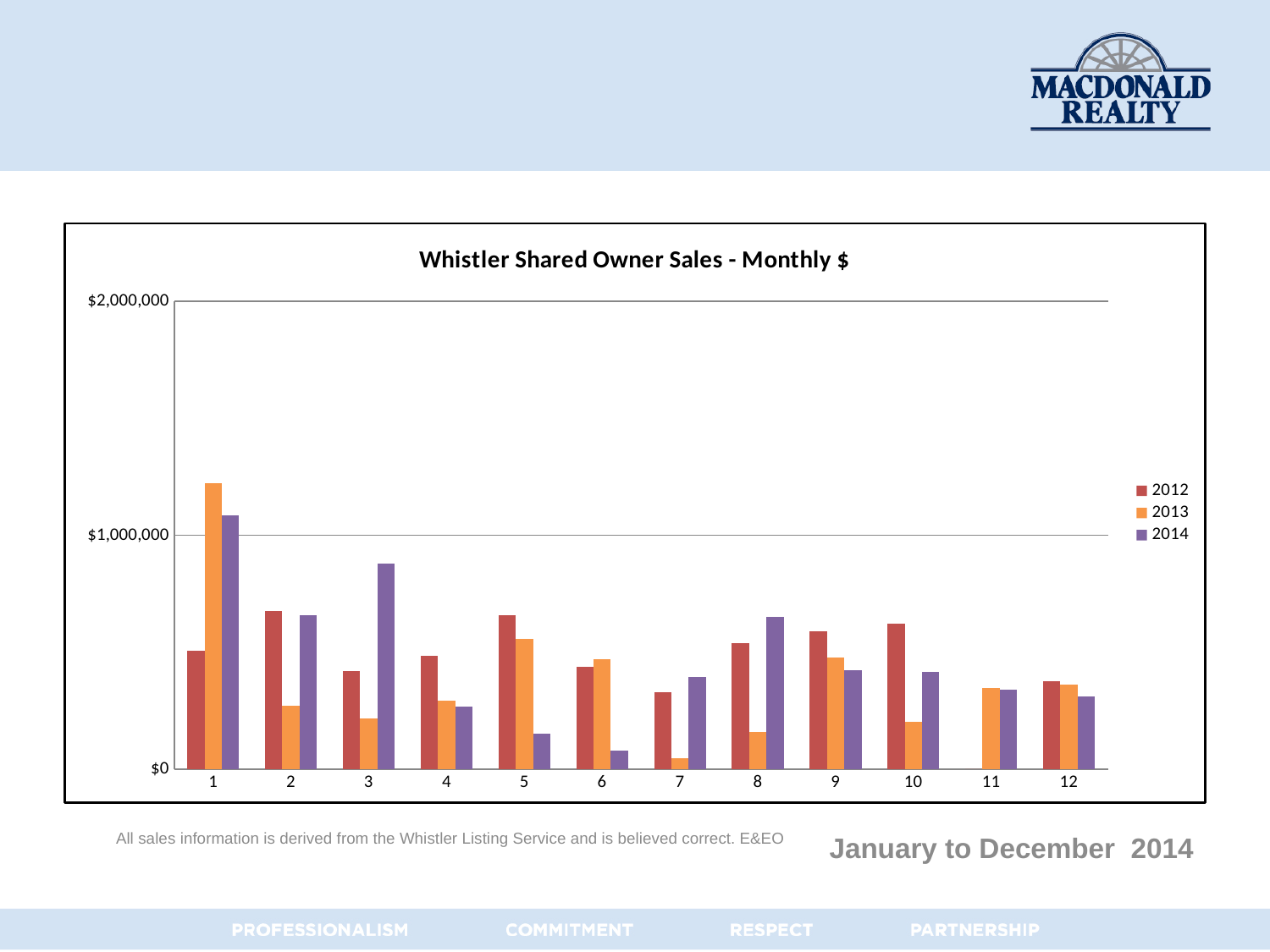
What kind of chart is shown on the slide? bar chart Which year does the purple series represent? 2014 In which month is the 2013 value highest? 1 What is the title of the chart? Whistler Shared Owner Sales - Monthly $ Is the 2014 value for month 3 greater or less than $1,000,000? less In which month is the 2014 value lowest? 6 In month 3, which year has the larger value, 2012 or 2014? 2014 Is the 2012 value for month 1 greater or less than $1,000,000? less How many series does the legend list? 3 How many months (categories) are shown on the x axis? 12 In month 10, which year has the larger value, 2012 or 2013? 2012 Is the 2013 value for month 1 greater or less than $1,000,000? greater